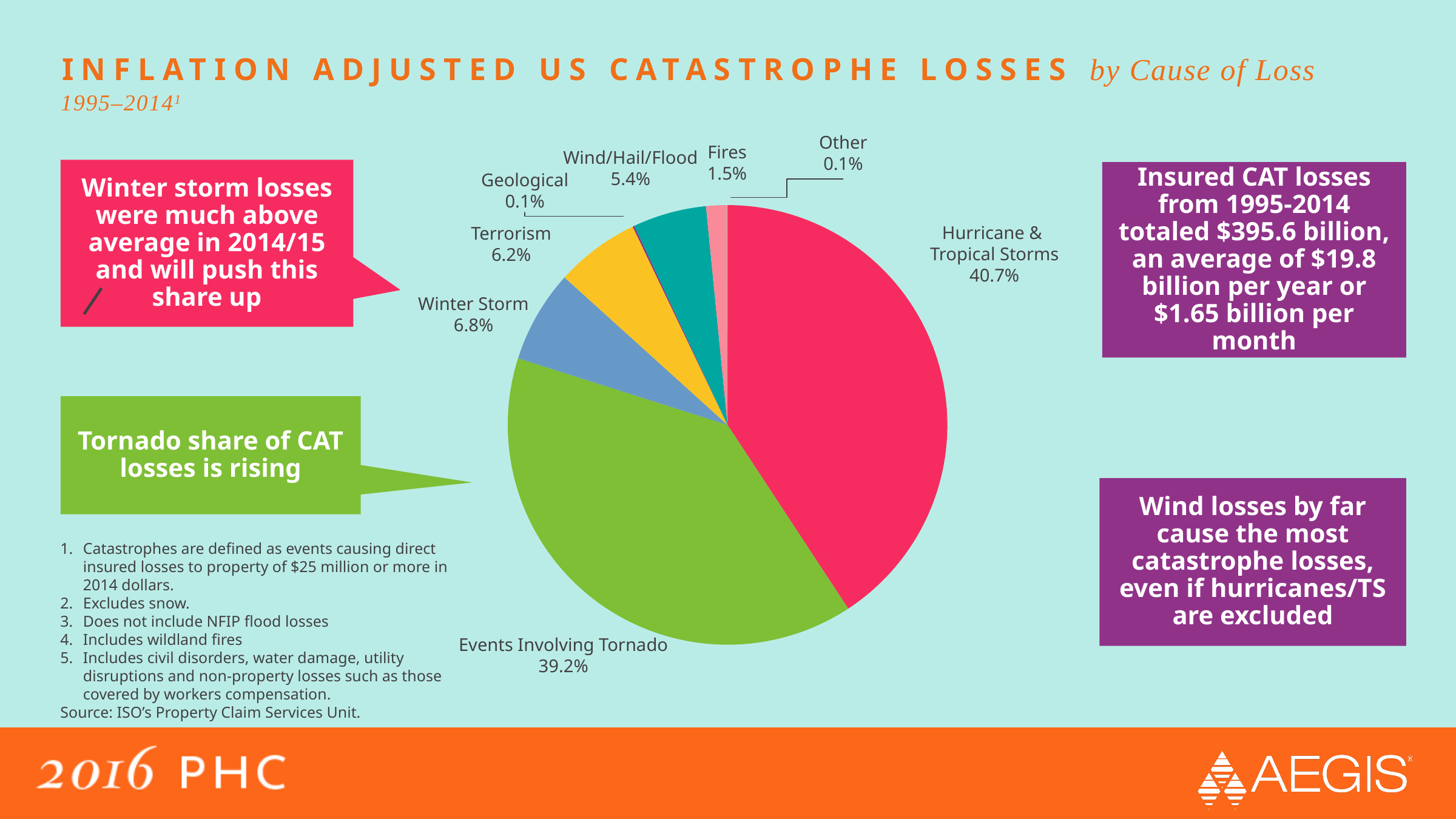
What share of losses is attributed to Fires? 1.5% Which cause of loss has the largest share of the pie? Hurricane & Tropical Storms What share of losses is attributed to Events Involving Tornado? 39.2% Which has a larger share, Winter Storm or Terrorism? Winter Storm How many causes of loss are shown in the pie chart? 8 What is the difference in percentage points between the Hurricane & Tropical Storms share and the Events Involving Tornado share? 1.5 percentage points What share of losses is attributed to Terrorism? 6.2% What share of losses is attributed to Winter Storm? 6.8% What kind of chart is shown on the slide? Pie chart What share of losses is attributed to Wind/Hail/Flood? 5.4% What is the combined share of Geological and Other losses? 0.2% What share of inflation adjusted US catastrophe losses is attributed to Hurricane & Tropical Storms? 40.7%